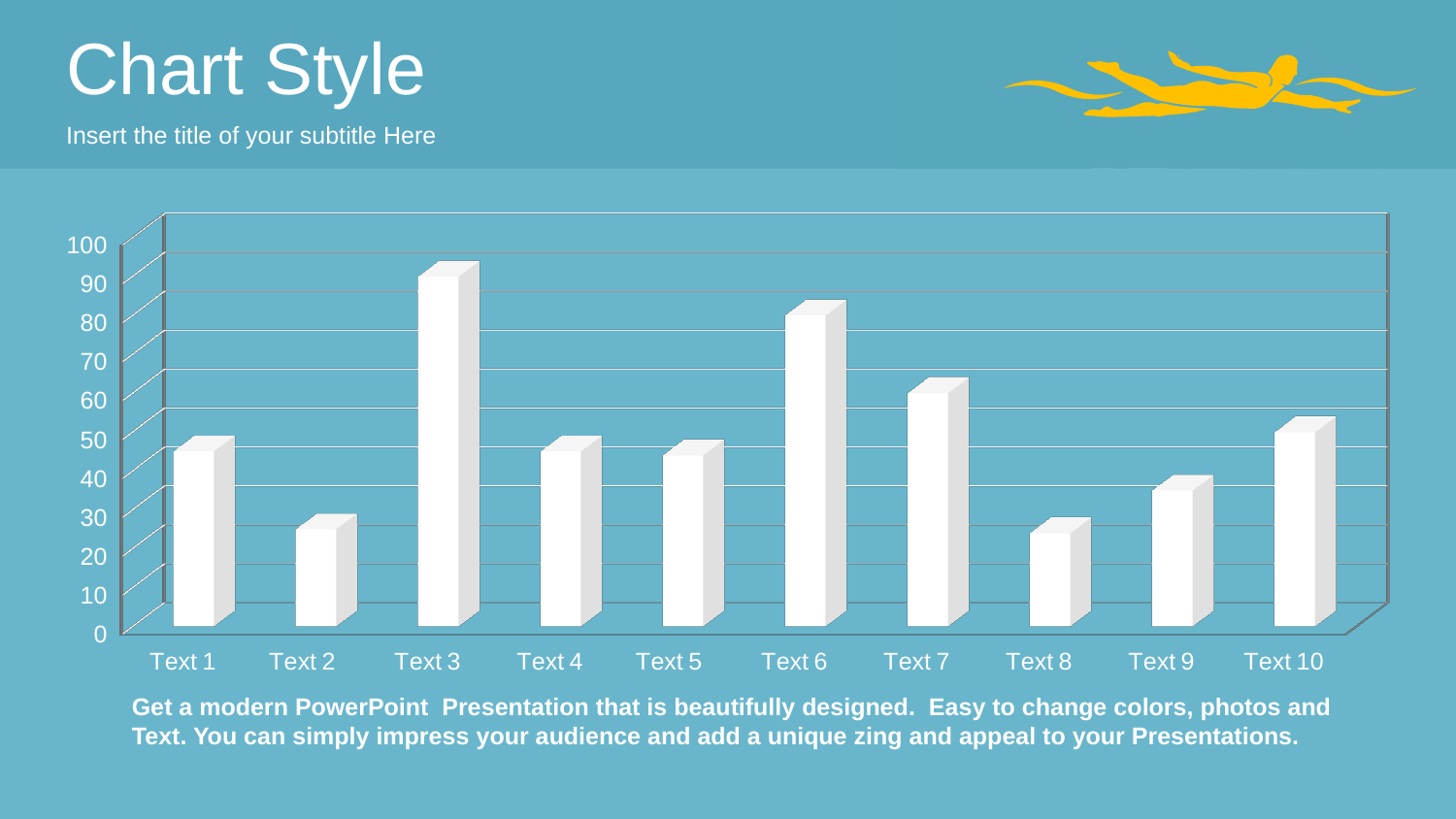
Is the value for Text 10 greater or less than 40? greater What kind of chart is shown on the slide? bar chart Which is larger, the value for Text 6 or the value for Text 7? Text 6 Is the value for Text 6 greater or less than 70? greater Is the value for Text 3 greater or less than 80? greater What is the highest value shown on the vertical axis of the chart? 100 Which category has the highest bar in the chart? Text 3 How many categories are plotted on the x axis of the chart? 10 Which is larger, the value for Text 9 or the value for Text 7? Text 7